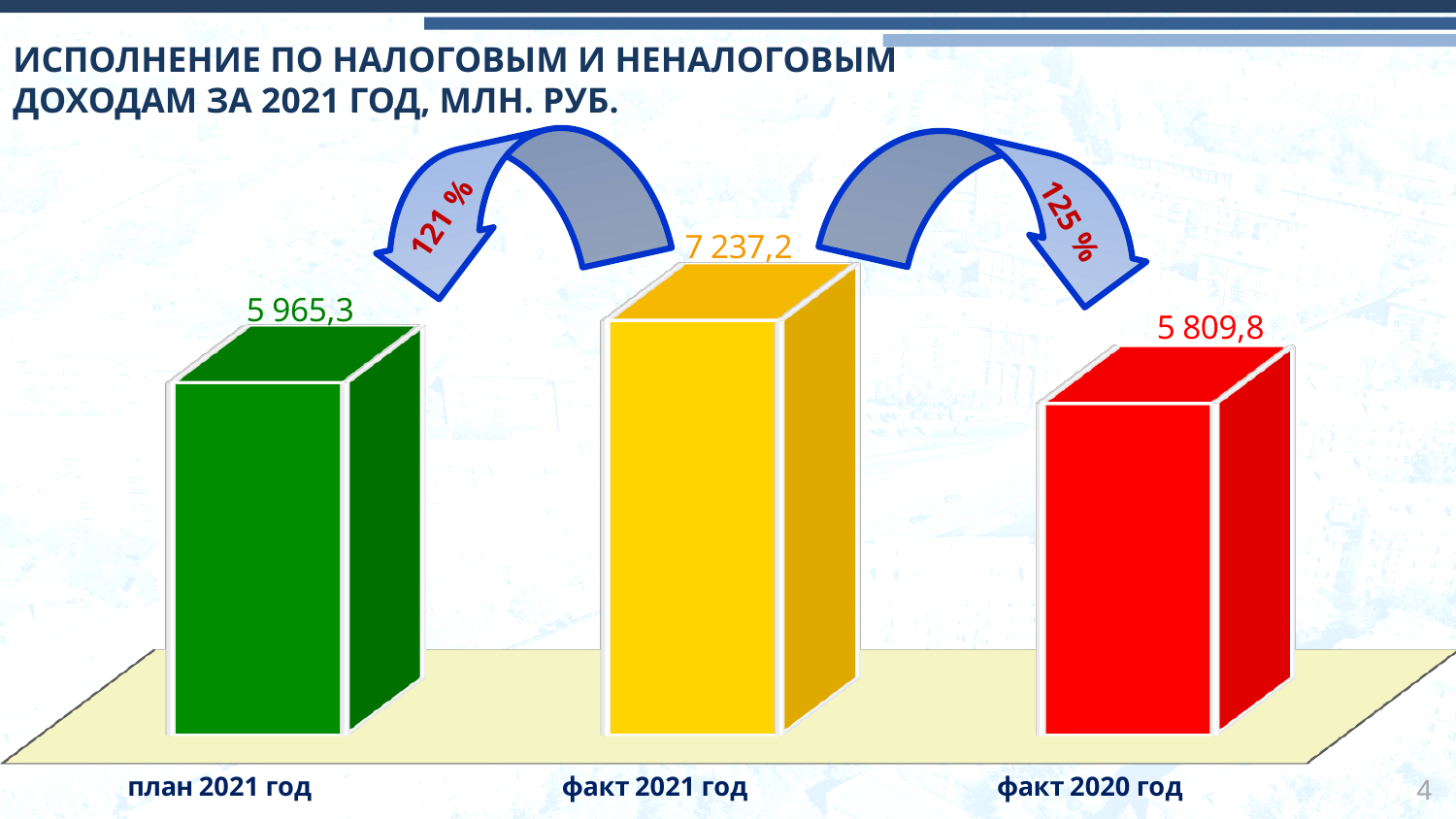
Which is larger, план 2021 год or факт 2020 год? план 2021 год What percentage is shown on the arrow between план 2021 год and факт 2021 год? 121 % Which category has the lowest value? факт 2020 год What is the difference between факт 2021 год and факт 2020 год? 1 427,4 What is the value for план 2021 год? 5 965,3 What is the value for факт 2021 год? 7 237,2 Which category has the highest value? факт 2021 год What colour is the bar for факт 2020 год? red What is the difference between факт 2021 год and план 2021 год? 1 271,9 How many bars are shown in the chart? 3 What kind of chart is shown on the slide? bar chart What is the value for факт 2020 год? 5 809,8